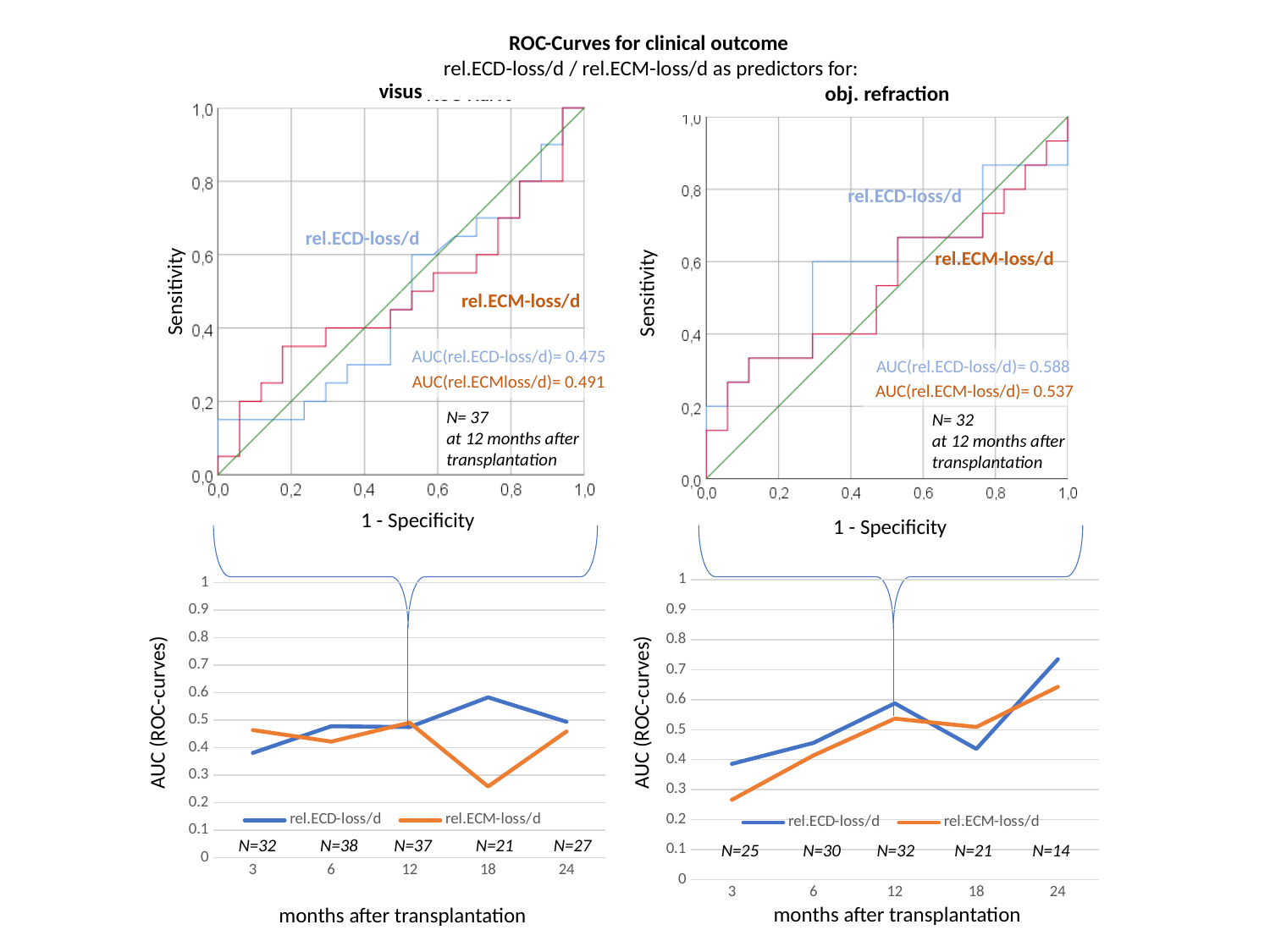
What kind of chart is the bottom-left chart showing AUC (ROC-curves) over months after transplantation? line chart In the top-right ROC chart for obj. refraction, what is the AUC for rel.ECM-loss/d? 0.537 How many series does the legend of the bottom-right AUC chart list? 2 In the bottom-left AUC chart, at which month is the rel.ECM-loss/d value lowest? 18 In the top-left ROC chart for visus, which predictor has the larger AUC, rel.ECD-loss/d or rel.ECM-loss/d? rel.ECM-loss/d In the top-right ROC chart for obj. refraction, what is the difference between the AUC of rel.ECD-loss/d and the AUC of rel.ECM-loss/d? 0.051 In the bottom-right AUC chart, does the rel.ECM-loss/d line rise or fall from 3 to 12 months? rise In the bottom-right AUC chart, at which month is the rel.ECD-loss/d value highest? 24 How many time points are plotted along the x axis of the bottom-left AUC chart? 5 In the top-left ROC chart for visus, what is the AUC for rel.ECD-loss/d? 0.475 In the bottom-left AUC chart, is the value for rel.ECM-loss/d at 18 months greater or less than 0.3? less In the bottom-right AUC chart, is the value for rel.ECD-loss/d at 24 months greater or less than 0.7? greater